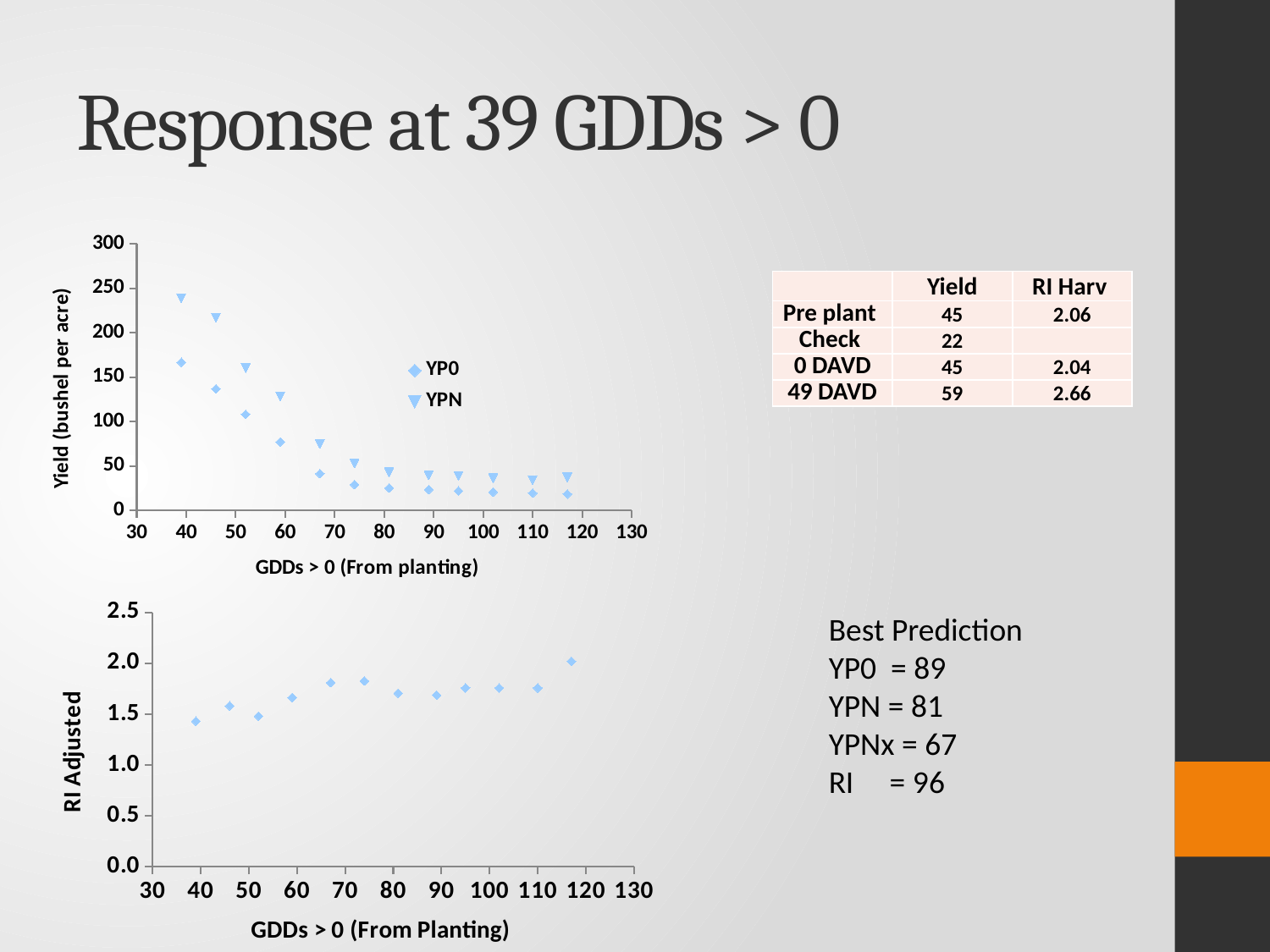
How many series does the legend of the top chart list? 2 In the top chart, is the leftmost YP0 point greater or less than 150 bushels per acre? greater In the top chart, do the YP0 values rise or fall as GDDs > 0 increases? fall How many data points are plotted for the YP0 series in the top chart? 12 What kind of chart is the bottom chart (RI Adjusted vs GDDs > 0)? scatter chart In the top chart, is the leftmost YPN point greater or less than 200 bushels per acre? greater What are the two series named in the legend of the top chart? YP0 and YPN In the top chart, at the leftmost GDD value, which series has the higher yield, YP0 or YPN? YPN What is the y-axis title of the bottom chart? RI Adjusted What kind of chart is the top chart (Yield vs GDDs > 0)? scatter chart In the bottom chart, is the leftmost point greater or less than 2.0? less In the bottom chart, do the RI Adjusted values generally rise or fall as GDDs > 0 increases? rise